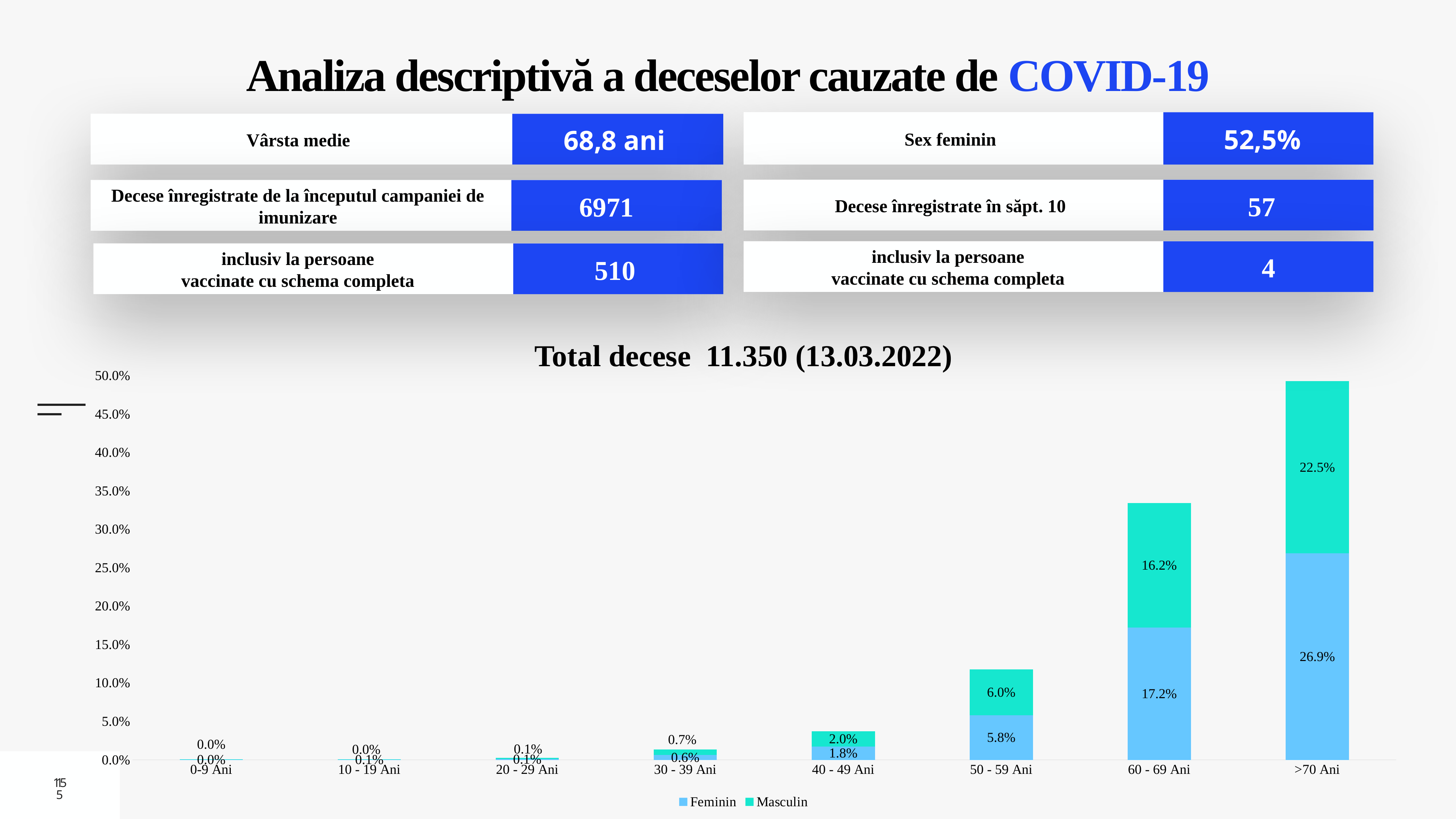
What is the total of the stacked bar for the 60 - 69 Ani category? 33.4% What is the difference between the Feminin and Masculin values for the >70 Ani category? 4.4% How many age categories are shown on the x axis of the chart? 8 Which age category has the highest Masculin value? >70 Ani What is the Masculin value for the 60 - 69 Ani category? 16.2% What is the Feminin value for the >70 Ani category? 26.9% What kind of chart is shown on the slide? stacked bar chart Is the Feminin value for 60 - 69 Ani larger or smaller than the Masculin value for the same category? larger Do the stacked bar totals rise or fall as the age categories move from left to right along the x axis? rise How many series does the chart legend list? 2 What is the Masculin value for the 40 - 49 Ani category? 2.0% What is the Feminin value for the 50 - 59 Ani category? 5.8%